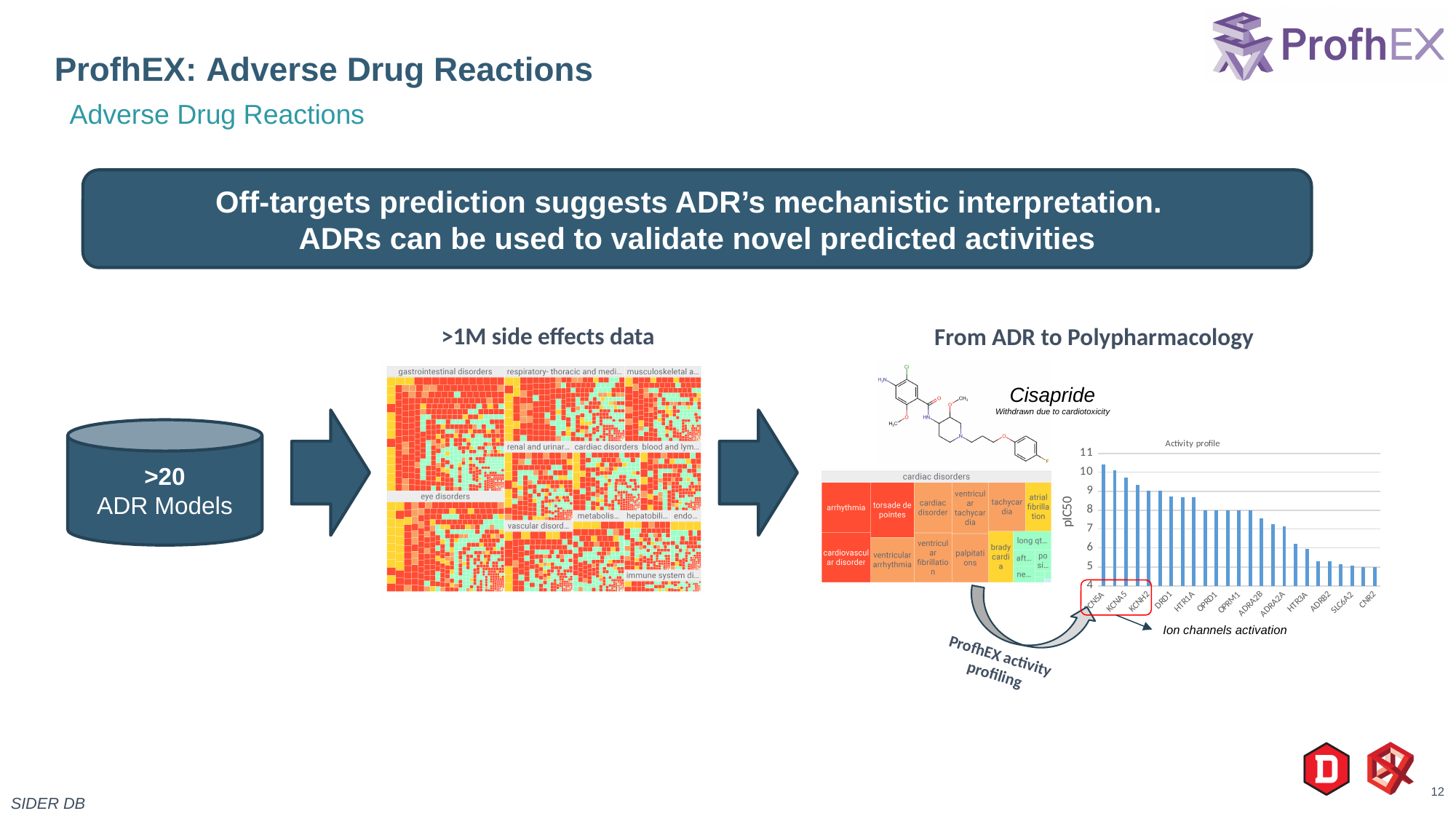
On the 'Activity profile' chart, is the value for HTR3A greater or less than 7? less On the 'Activity profile' chart, which has the larger pIC50 value, KCNA5 or CNR2? KCNA5 On the 'Activity profile' chart, is the value for DRD1 greater or less than 7? greater What is the title of the chart on the right of the slide? Activity profile On the 'Activity profile' chart, which has the larger pIC50 value, OPRM1 or SLC6A2? OPRM1 On the 'Activity profile' chart, do the bar values rise or fall from left to right along the x axis? fall What is the label of the y axis on the 'Activity profile' chart? pIC50 On the 'Activity profile' chart, is the value for ADRB2 greater or less than 6? less What type of chart is the 'Activity profile' chart on the right of the slide? bar chart